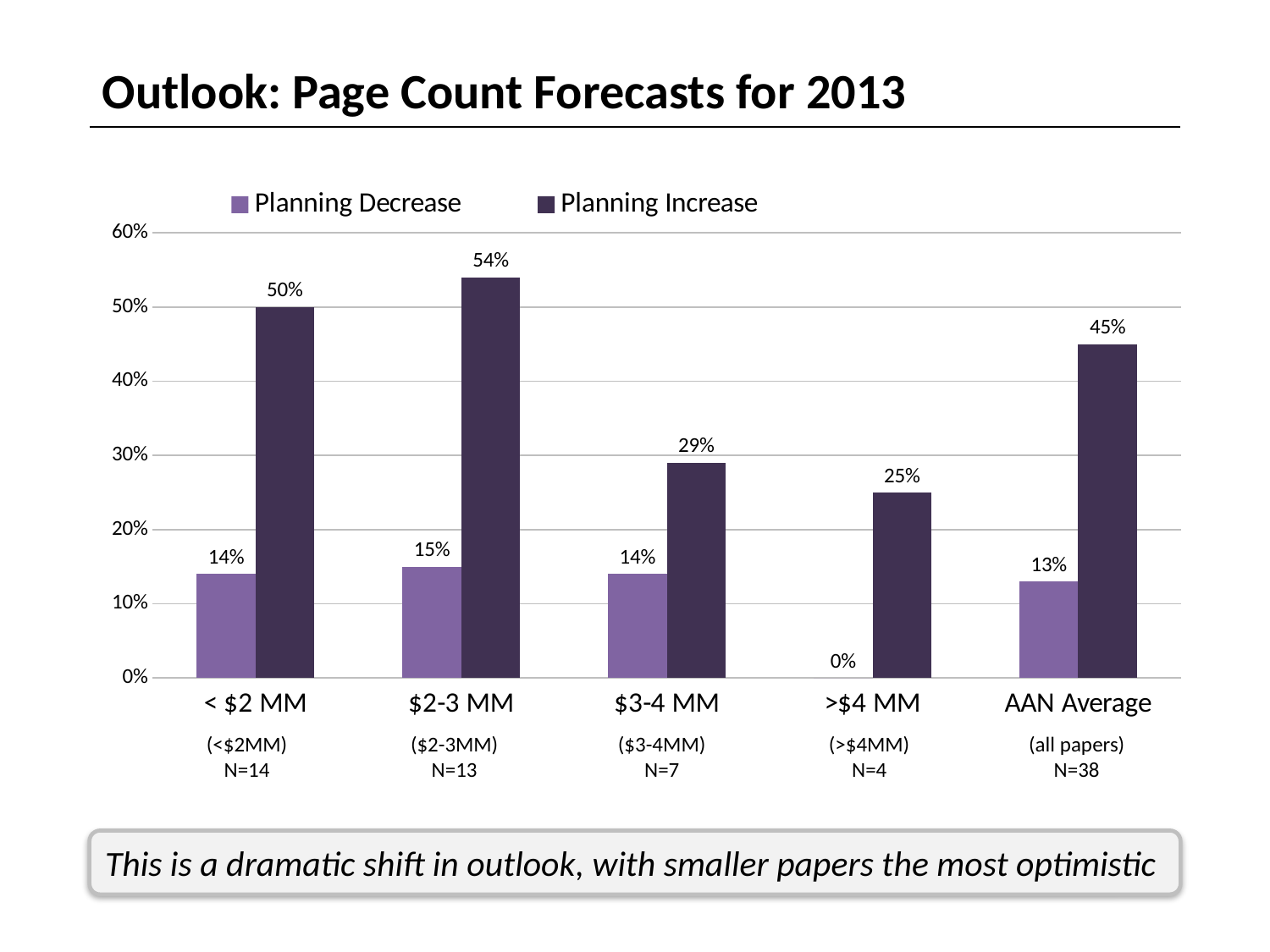
Which category has the highest Planning Increase value? $2-3 MM What is the Planning Decrease value for the >$4 MM category? 0% What is the sample size (N) shown for the AAN Average category? N=38 What is the Planning Increase value for AAN Average? 45% What is the difference between Planning Increase and Planning Decrease for the < $2 MM category? 36% Which category has the lowest Planning Increase value? >$4 MM What percentage of papers in the $2-3 MM category are planning an increase in page count? 54% How many categories are shown on the x axis? 5 What kind of chart is shown on the slide? Bar chart Which is larger for the $3-4 MM category: Planning Decrease or Planning Increase? Planning Increase How many series does the legend list? 2 Does the Planning Increase value rise or fall from < $2 MM to >$4 MM? Fall